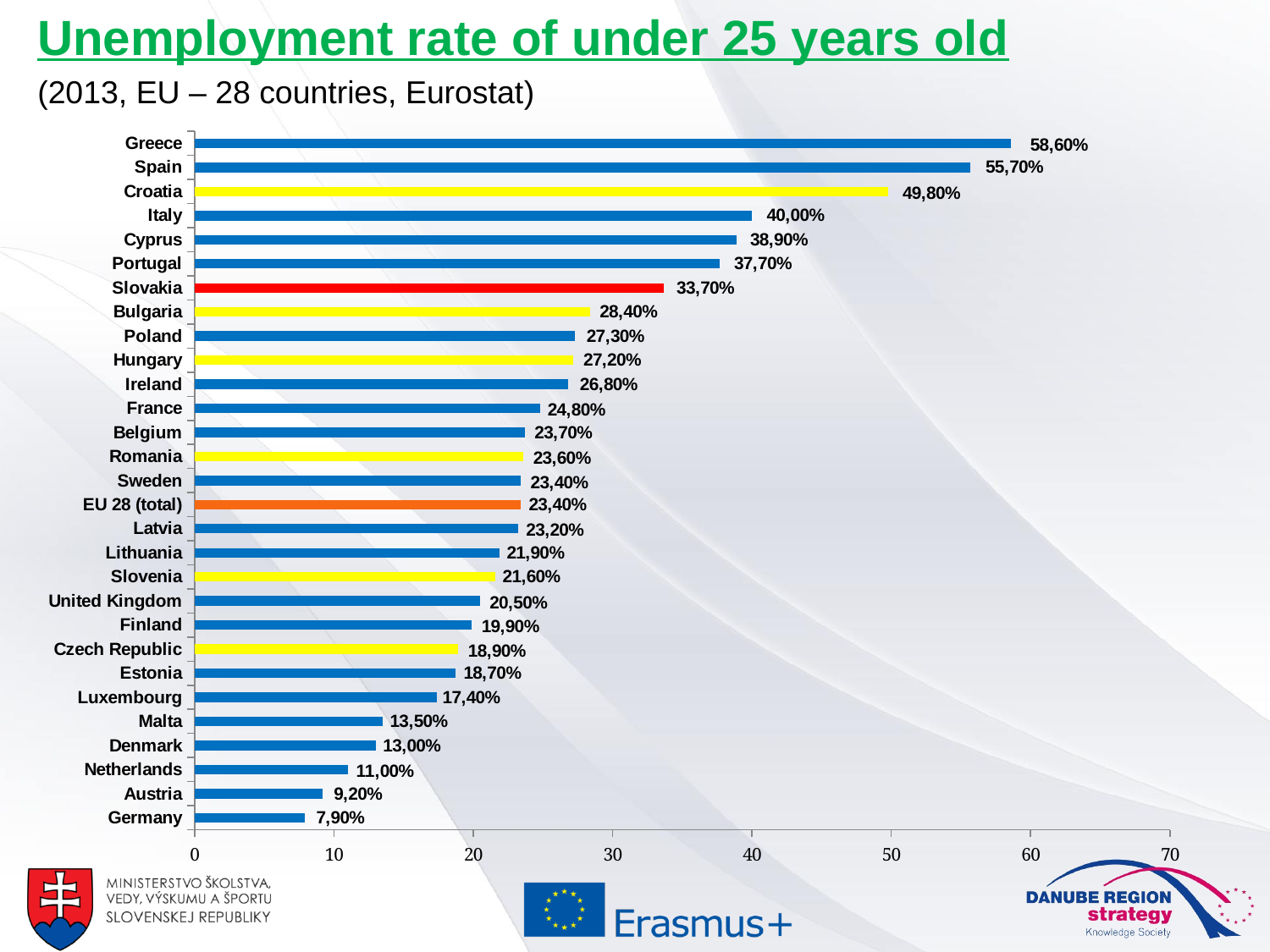
What is the value shown for EU 28 (total)? 23,40% Is the value for Portugal greater or less than 40? less What is the difference between the values for Greece and Spain? 2,90% How many bars are plotted on the chart? 29 What kind of chart is shown on the slide? bar chart Which country has the lowest unemployment rate on the chart? Germany Which has a higher unemployment rate, Croatia or Italy? Croatia Which country has the highest unemployment rate on the chart? Greece What is the difference between the values for Slovakia and EU 28 (total)? 10,30% What is the unemployment rate shown for Germany? 7,90% What colour is the bar for Slovakia? red What is the unemployment rate shown for Slovakia? 33,70%